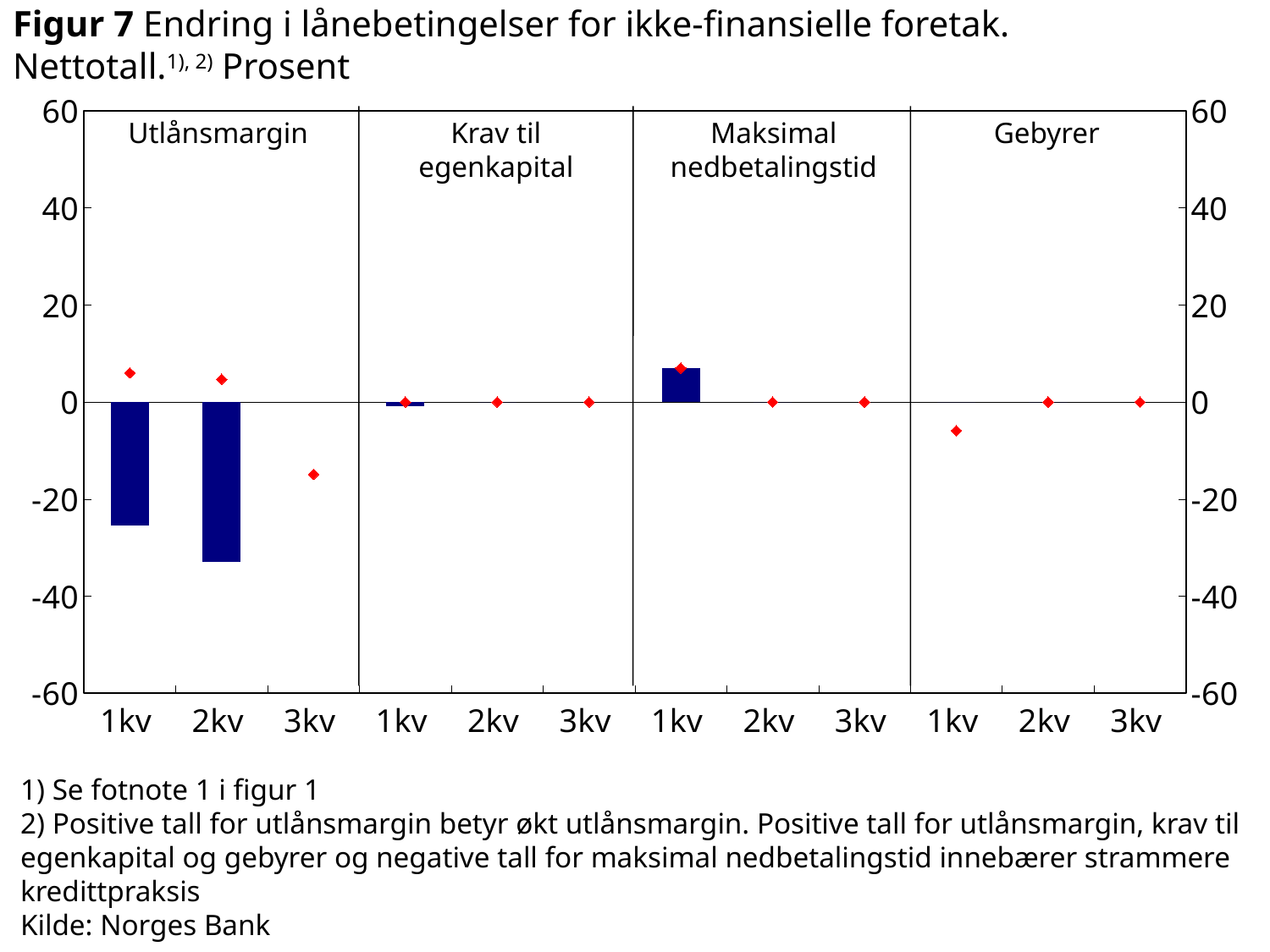
Is the bar for Maksimal nedbetalingstid in 1kv greater or less than 0? greater Is the bar for Utlånsmargin in 2kv greater or less than -20? less Is the red diamond for Utlånsmargin in 3kv greater or less than -10? less How many panels (loan condition categories) does the chart have? 4 Which bar is the lowest (most negative) in the whole chart? Utlånsmargin 2kv How many quarters are shown on the x axis within each panel? 3 For Utlånsmargin, which bar is lower, 1kv or 2kv? 2kv What is the source given for the chart? Norges Bank What kind of chart is shown in Figur 7? bar chart Which bar is the highest in the whole chart? Maksimal nedbetalingstid 1kv